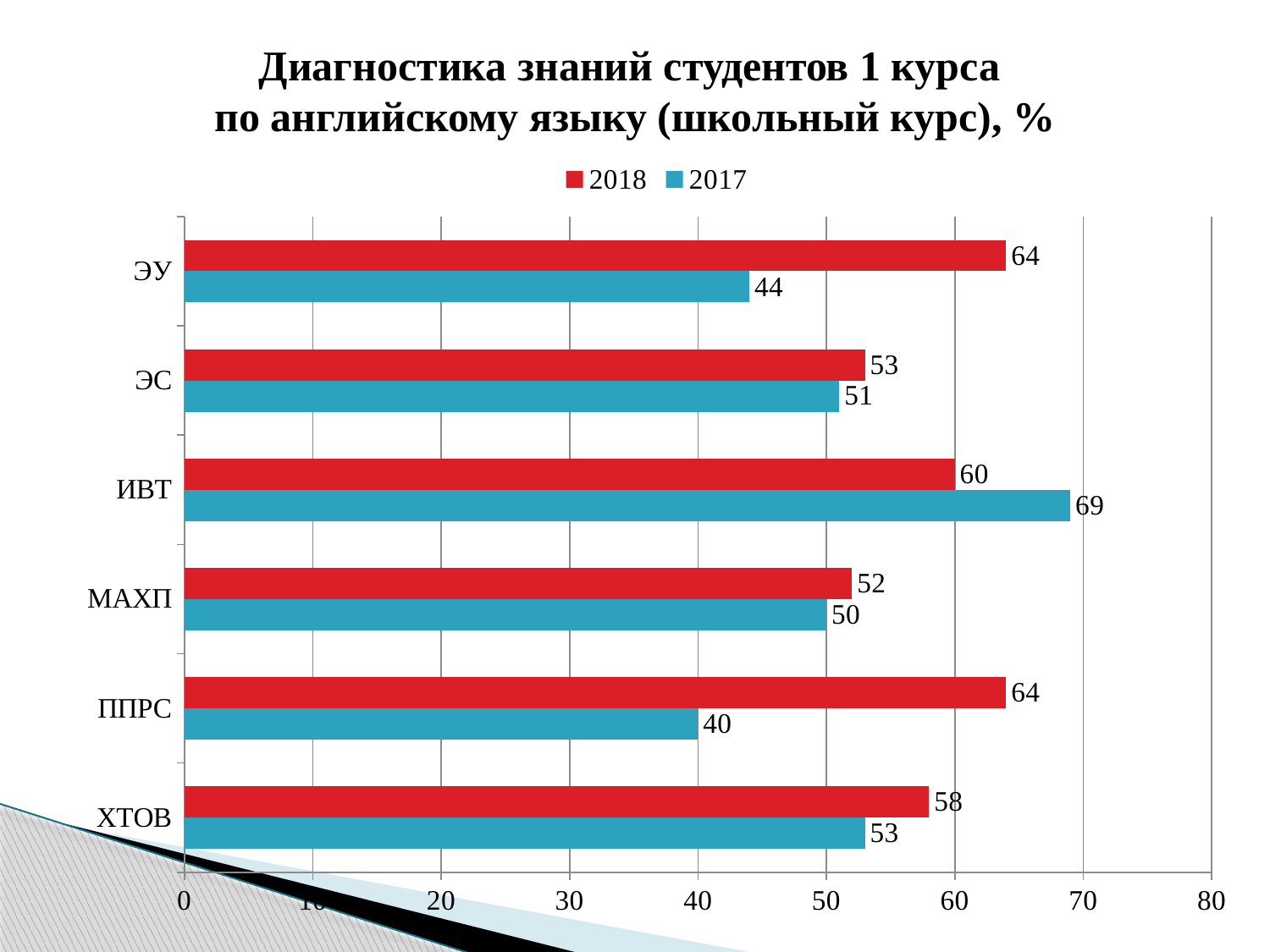
Which category has the highest 2017 value? ИВТ What type of chart is shown on the slide? bar chart What is the 2018 value for ЭУ? 64 How many series does the legend list? 2 Is the 2018 value for ХТОВ greater or less than 50? greater Which series is shown in red? 2018 What is the 2017 value for ППРС? 40 What is the difference between the 2018 and 2017 values for ППРС? 24 What is the 2017 value for ИВТ? 69 Which category has the lowest 2017 value? ППРС Which is larger for ИВТ, the 2018 value or the 2017 value? 2017 How many categories are shown on the chart? 6